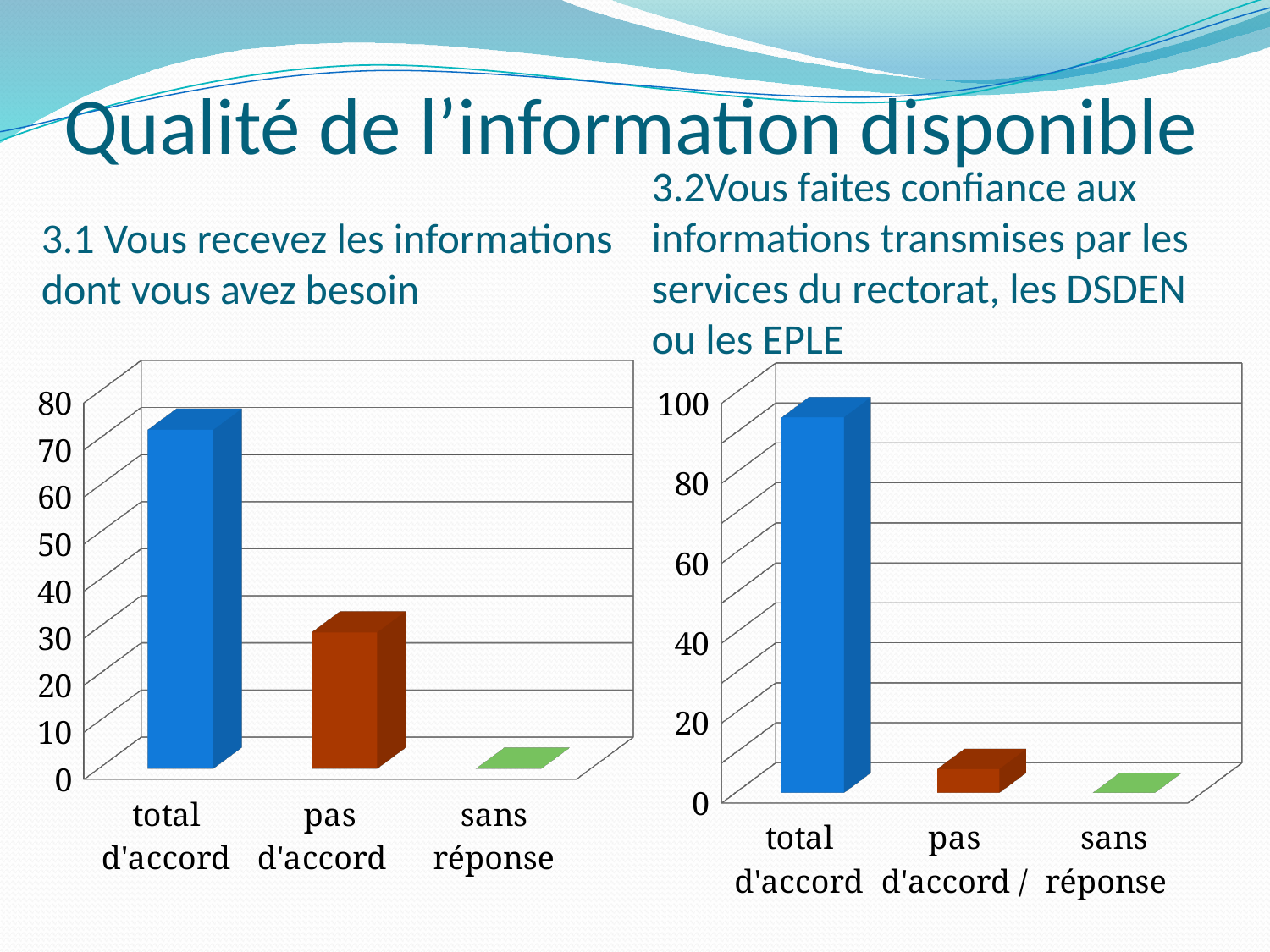
On the right chart (3.2 Vous faites confiance aux informations transmises...), which is larger: total d'accord or pas d'accord /? total d'accord What kind of chart is the left chart (3.1 Vous recevez les informations dont vous avez besoin)? bar chart On the right chart (3.2 Vous faites confiance aux informations transmises...), which category has the highest value? total d'accord On the left chart (3.1 Vous recevez les informations dont vous avez besoin), is the value for total d'accord greater or less than 60? greater On the left chart (3.1 Vous recevez les informations dont vous avez besoin), how many categories are shown on the x axis? 3 On the left chart (3.1 Vous recevez les informations dont vous avez besoin), which category has the lowest value? sans réponse On the left chart (3.1 Vous recevez les informations dont vous avez besoin), which category has the highest value? total d'accord On the right chart (3.2 Vous faites confiance aux informations transmises...), is the value for pas d'accord / greater or less than 20? less On the left chart (3.1 Vous recevez les informations dont vous avez besoin), is the value for pas d'accord greater or less than 40? less On the left chart (3.1 Vous recevez les informations dont vous avez besoin), what colour is the bar for pas d'accord? red On the right chart (3.2 Vous faites confiance aux informations transmises...), what is the highest value shown on the vertical axis? 100